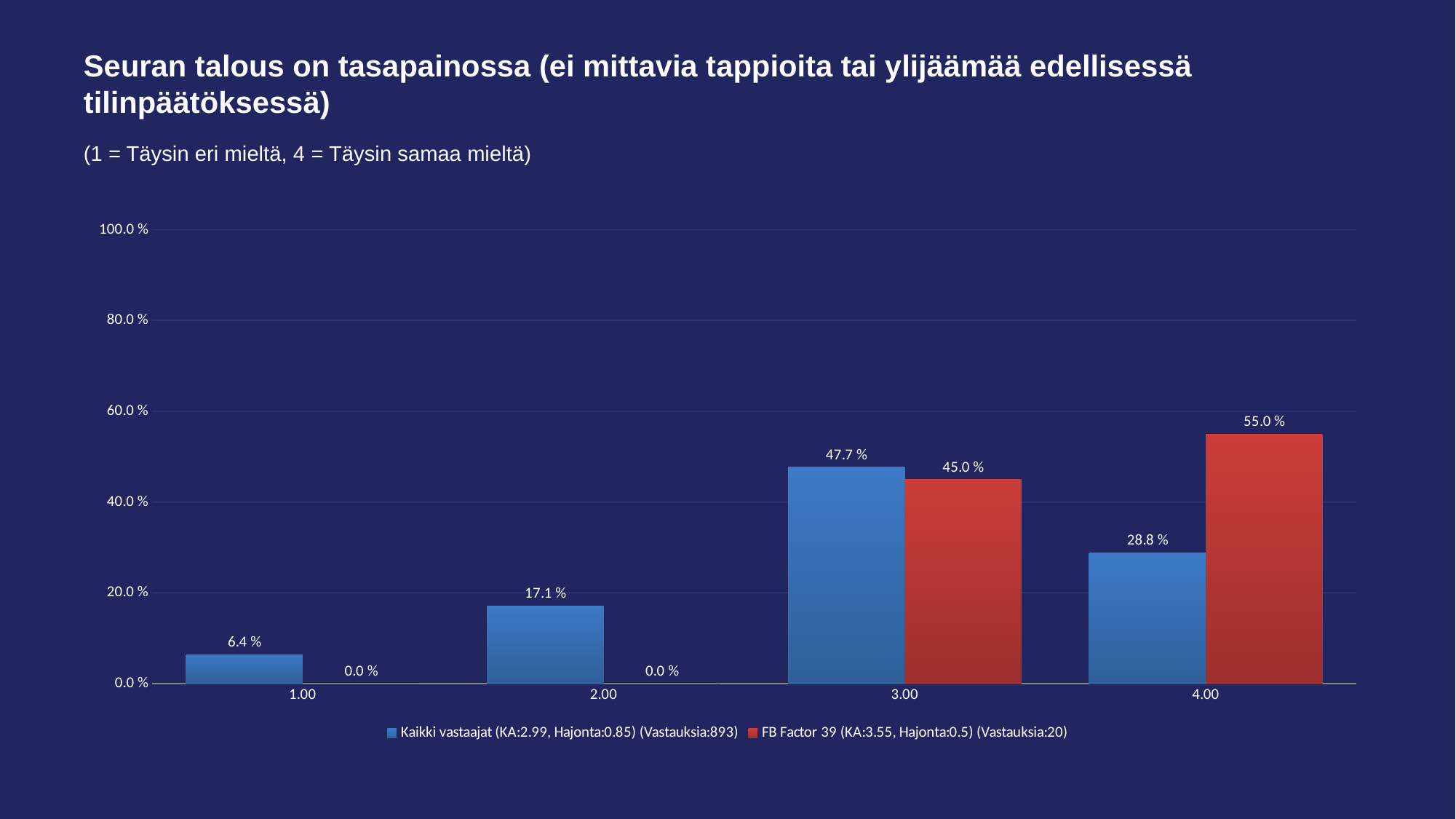
What is the value for FB Factor 39 at 4.00? 55.0 % What kind of chart is shown on the slide? Bar chart Which category has the lowest value for Kaikki vastaajat? 1.00 How many categories are shown on the x axis? 4 What is the value for FB Factor 39 at 2.00? 0.0 % Which category has the highest value for Kaikki vastaajat? 3.00 What is the difference between the FB Factor 39 value and the Kaikki vastaajat value at 4.00? 26.2 % At 3.00, which series has the larger value, Kaikki vastaajat or FB Factor 39? Kaikki vastaajat Is the value for Kaikki vastaajat at 2.00 greater or less than 20.0 %? less How many series does the legend list? 2 What is the value for Kaikki vastaajat at 1.00? 6.4 % What is the value for Kaikki vastaajat at 3.00? 47.7 %